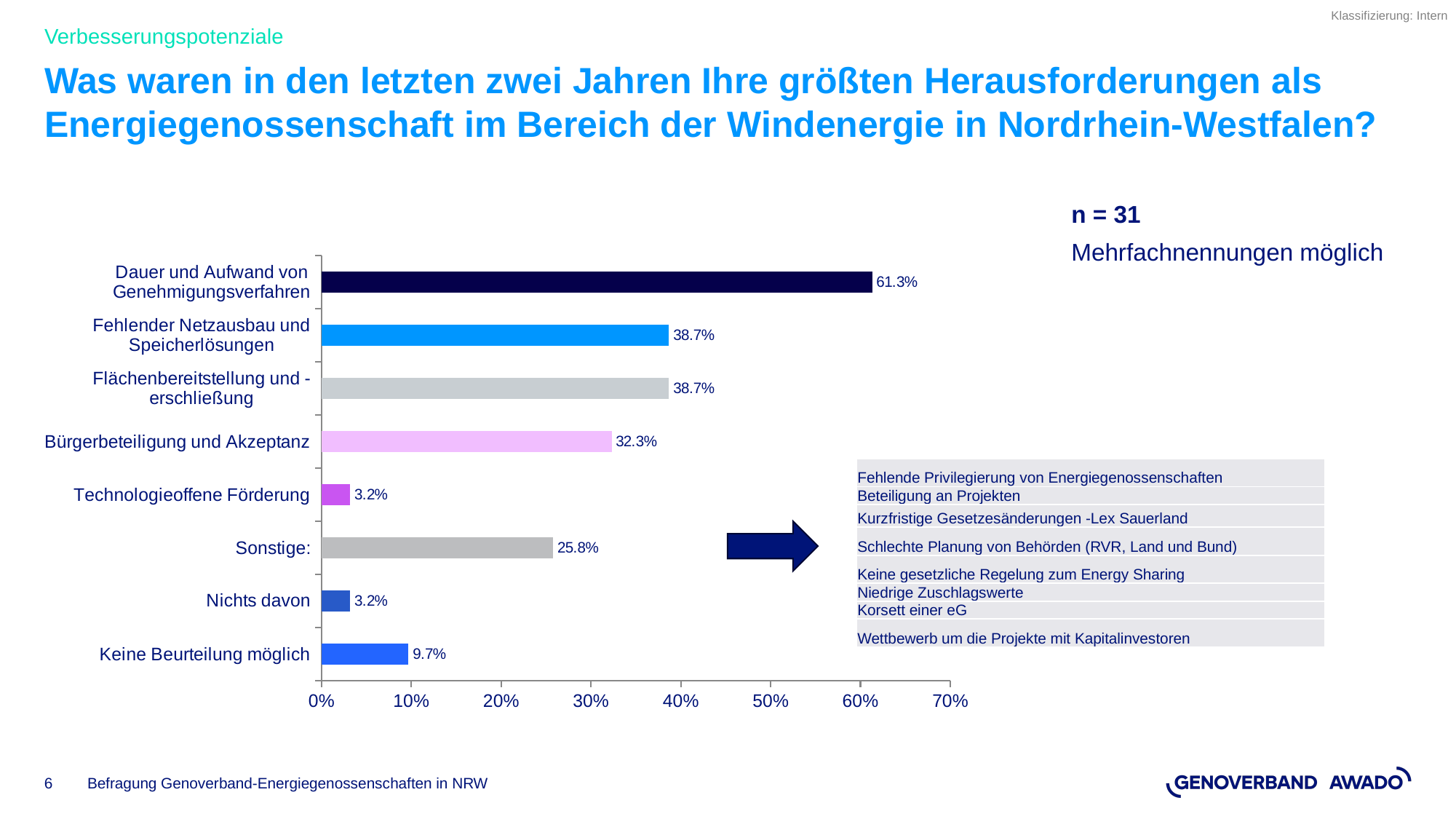
What is the value for "Dauer und Aufwand von Genehmigungsverfahren"? 61.3% What is the difference between the values for "Dauer und Aufwand von Genehmigungsverfahren" and "Fehlender Netzausbau und Speicherlösungen"? 22.6 percentage points Which category has the highest value? Dauer und Aufwand von Genehmigungsverfahren What is the value for "Sonstige:"? 25.8% What is the difference between the values for "Bürgerbeteiligung und Akzeptanz" and "Sonstige:"? 6.5 percentage points What is the value for "Keine Beurteilung möglich"? 9.7% What kind of chart is shown on the slide? Bar chart What is the value for "Bürgerbeteiligung und Akzeptanz"? 32.3% How many categories are plotted in the bar chart? 8 What sample size (n) is stated next to the chart? n = 31 Which is larger, the value for "Keine Beurteilung möglich" or the value for "Nichts davon"? Keine Beurteilung möglich Is the value for "Bürgerbeteiligung und Akzeptanz" greater or less than 30%? greater